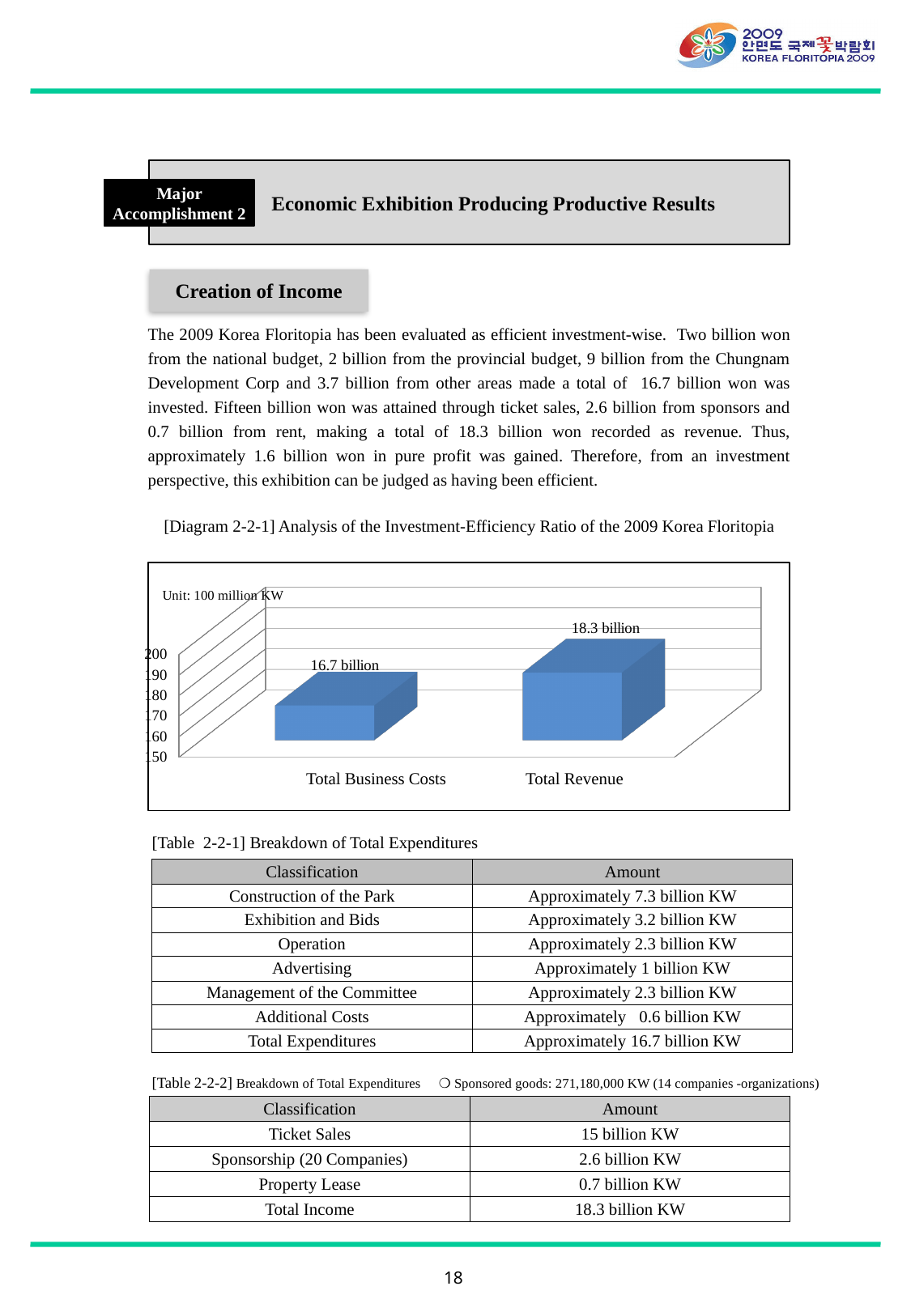
What is the value shown for Total Revenue? 18.3 billion Is Total Business Costs larger or smaller than Total Revenue? smaller What is the difference between Total Revenue and Total Business Costs? 1.6 billion Is the value for Total Revenue greater or less than 170? greater What is the title of the diagram containing the chart? [Diagram 2-2-1] Analysis of the Investment-Efficiency Ratio of the 2009 Korea Floritopia Is the value for Total Business Costs greater or less than 160? greater What is the value shown for Total Business Costs? 16.7 billion Which category has the higher value, Total Business Costs or Total Revenue? Total Revenue Which category has the lowest value in the chart? Total Business Costs What unit is stated in the top-left corner of the chart? 100 million KW What kind of chart is shown in Diagram 2-2-1? bar chart How many categories are plotted in the chart? 2